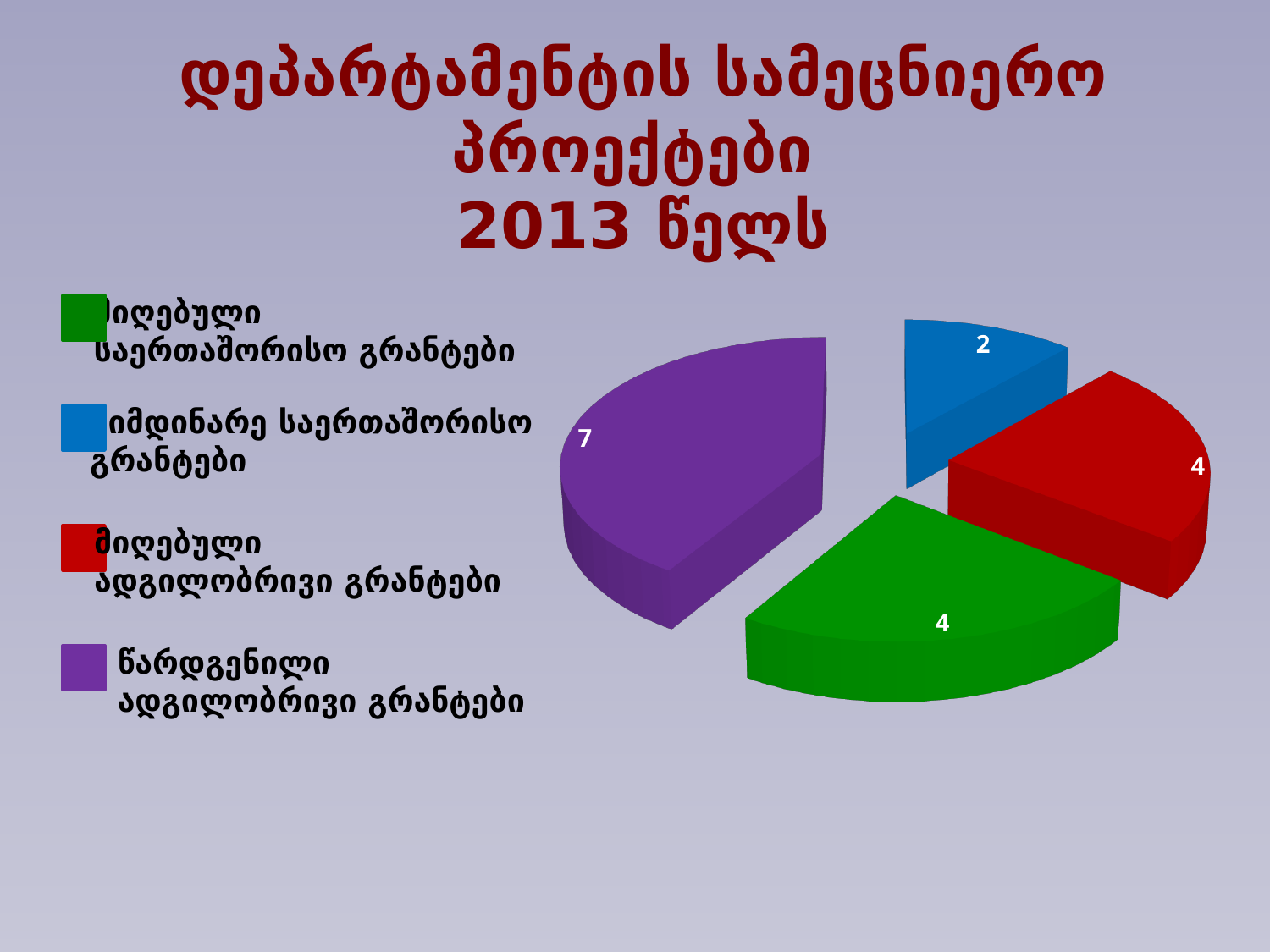
Which category has the smallest slice in the pie chart? იმდინარე საერთაშორისო გრანტები Which category has the largest slice in the pie chart? წარდგენილი ადგილობრივი გრანტები What is the value of the red slice (მიღებული ადგილობრივი გრანტები)? 4 How many entries does the legend list? 4 What is the value of the blue slice (იმდინარე საერთაშორისო გრანტები)? 2 What is the value of the green slice (მიღებული საერთაშორისო გრანტები)? 4 What type of chart is shown on the slide? pie chart What is the value of the purple slice (წარდგენილი ადგილობრივი გრანტები)? 7 Which is larger, the purple slice (წარდგენილი ადგილობრივი გრანტები) or the red slice (მიღებული ადგილობრივი გრანტები)? წარდგენილი ადგილობრივი გრანტები How many slices does the pie chart have? 4 What is the difference between the purple slice (7) and the blue slice (2)? 5 What is the total of all slices in the pie chart? 17